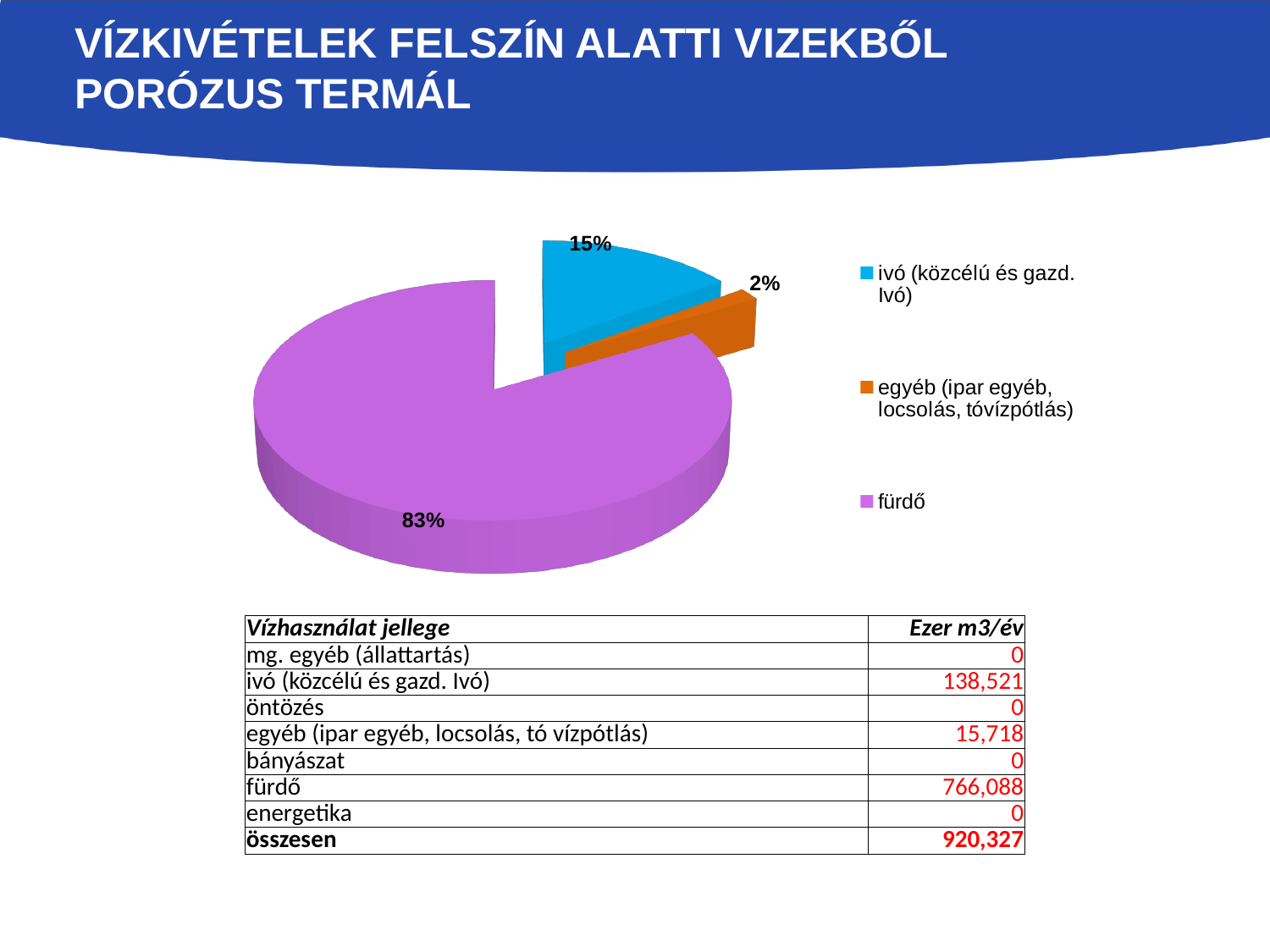
What is the difference in percentage points between the fürdő share and the ivó (közcélú és gazd. Ivó) share? 68% What colour is the fürdő slice in the pie chart? purple Which is larger, the share for ivó (közcélú és gazd. Ivó) or the share for egyéb (ipar egyéb, locsolás, tóvízpótlás)? ivó (közcélú és gazd. Ivó) Which category has the largest slice of the pie? fürdő What colour is the ivó (közcélú és gazd. Ivó) slice in the pie chart? blue What share of the pie does the egyéb (ipar egyéb, locsolás, tóvízpótlás) slice represent? 2% What share of the pie does the ivó (közcélú és gazd. Ivó) slice represent? 15% What kind of chart is shown on the slide? pie chart What share of the pie does the fürdő slice represent? 83% How many entries does the legend list? 3 How many slices does the pie chart have? 3 Which category has the smallest slice of the pie? egyéb (ipar egyéb, locsolás, tóvízpótlás)